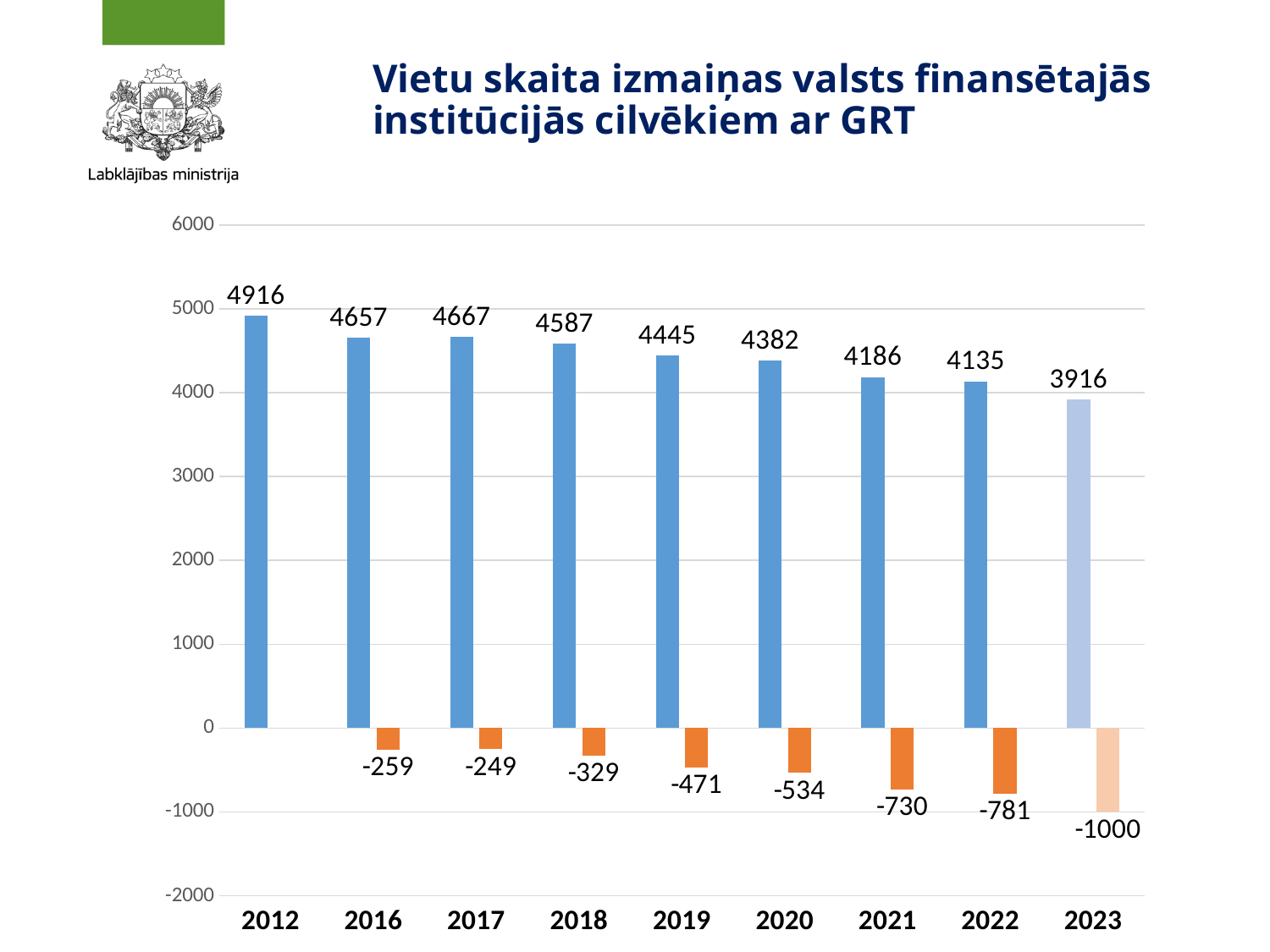
Do the blue bar values rise or fall from 2017 to 2023? fall What is the value of the light blue bar for 2023? 3916 What is the value of the blue bar for 2012? 4916 What kind of chart is shown on the slide? bar chart Which year has the lowest blue bar value? 2023 What is the value of the orange bar for 2021? -730 Is the blue bar value for 2022 greater or less than 4000? greater Which is larger, the blue bar value for 2016 or for 2017? 2017 How many years are shown on the x axis? 9 Which year has the highest blue bar value? 2012 Which year has the largest negative (orange) value? 2023 What is the difference between the blue bar values for 2012 and 2023? 1000